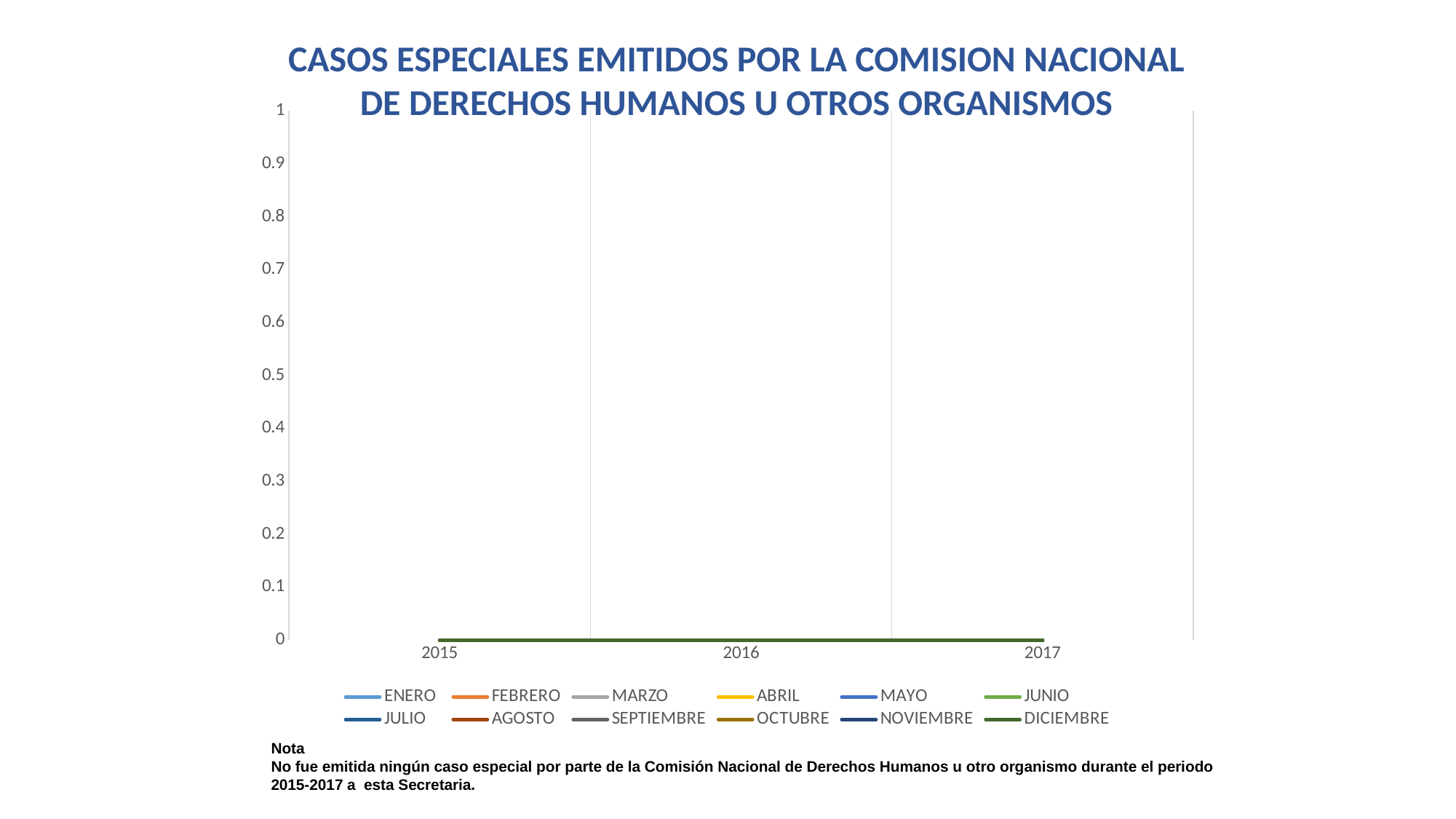
What is the highest value shown on the y axis? 1 What is the value for DICIEMBRE in 2015? 0 Do the plotted values rise, fall, or stay flat from 2015 to 2017? stay flat Which year is the first category on the x axis? 2015 What is the value for DICIEMBRE in 2016? 0 Is the value for DICIEMBRE in 2016 greater or less than 0.5? less How many years are shown along the x axis? 3 How many series does the legend list? 12 What is the value for DICIEMBRE in 2017? 0 What kind of chart is shown on the slide? line chart